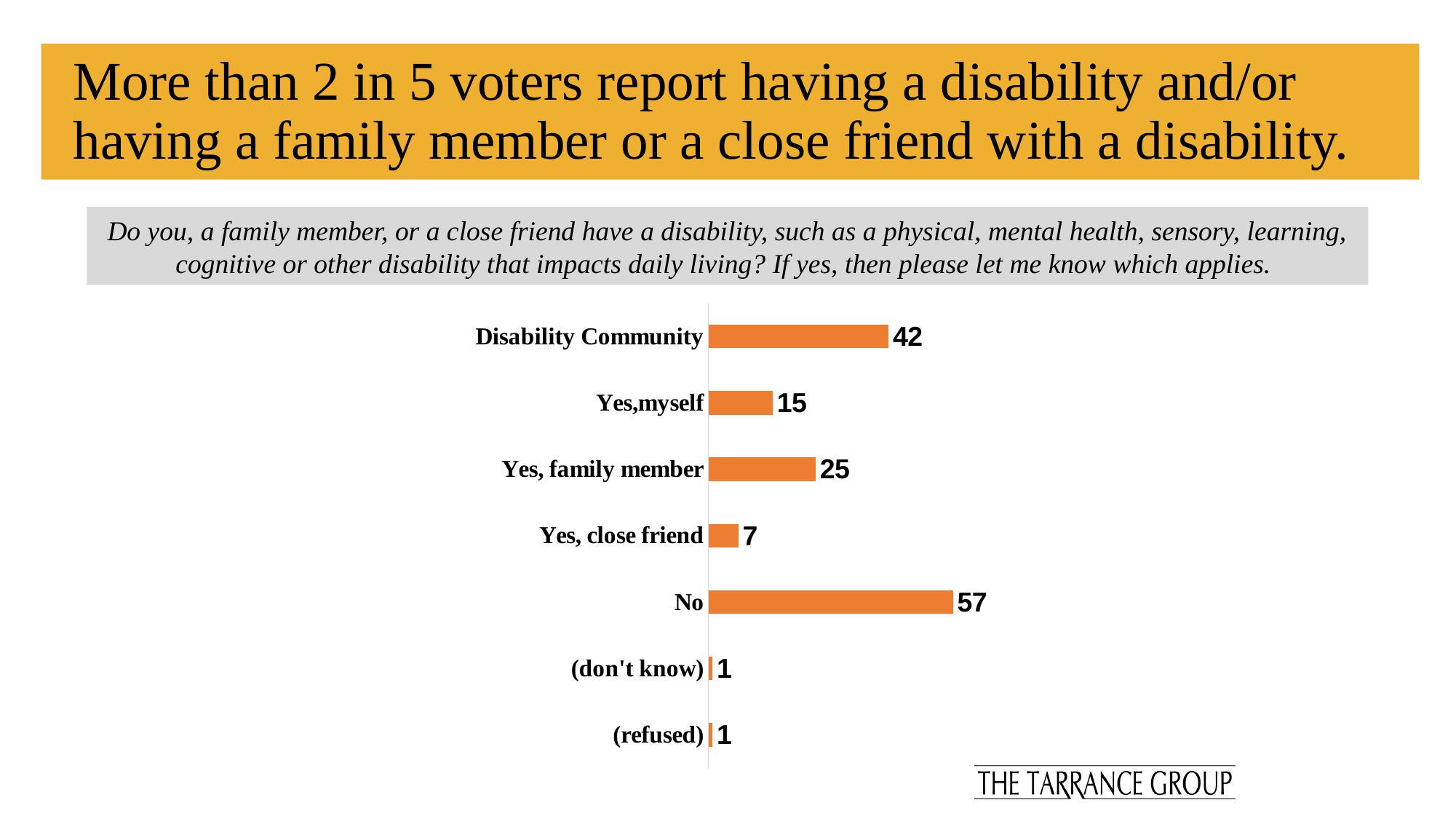
What kind of chart is shown on the slide? Bar chart What value is shown for "Disability Community"? 42 What is the difference between the values for "Yes, family member" and "Yes,myself"? 10 What value is shown for "Yes, family member"? 25 What is the difference between the values for "No" and "Disability Community"? 15 What value is shown for "(don't know)"? 1 What value is shown for "Yes, close friend"? 7 How many categories are shown in the chart? 7 Which category has the highest value? No Which is larger, the value for "Yes,myself" or the value for "Yes, close friend"? Yes,myself What colour are the bars in the chart? Orange What value is shown for "No"? 57